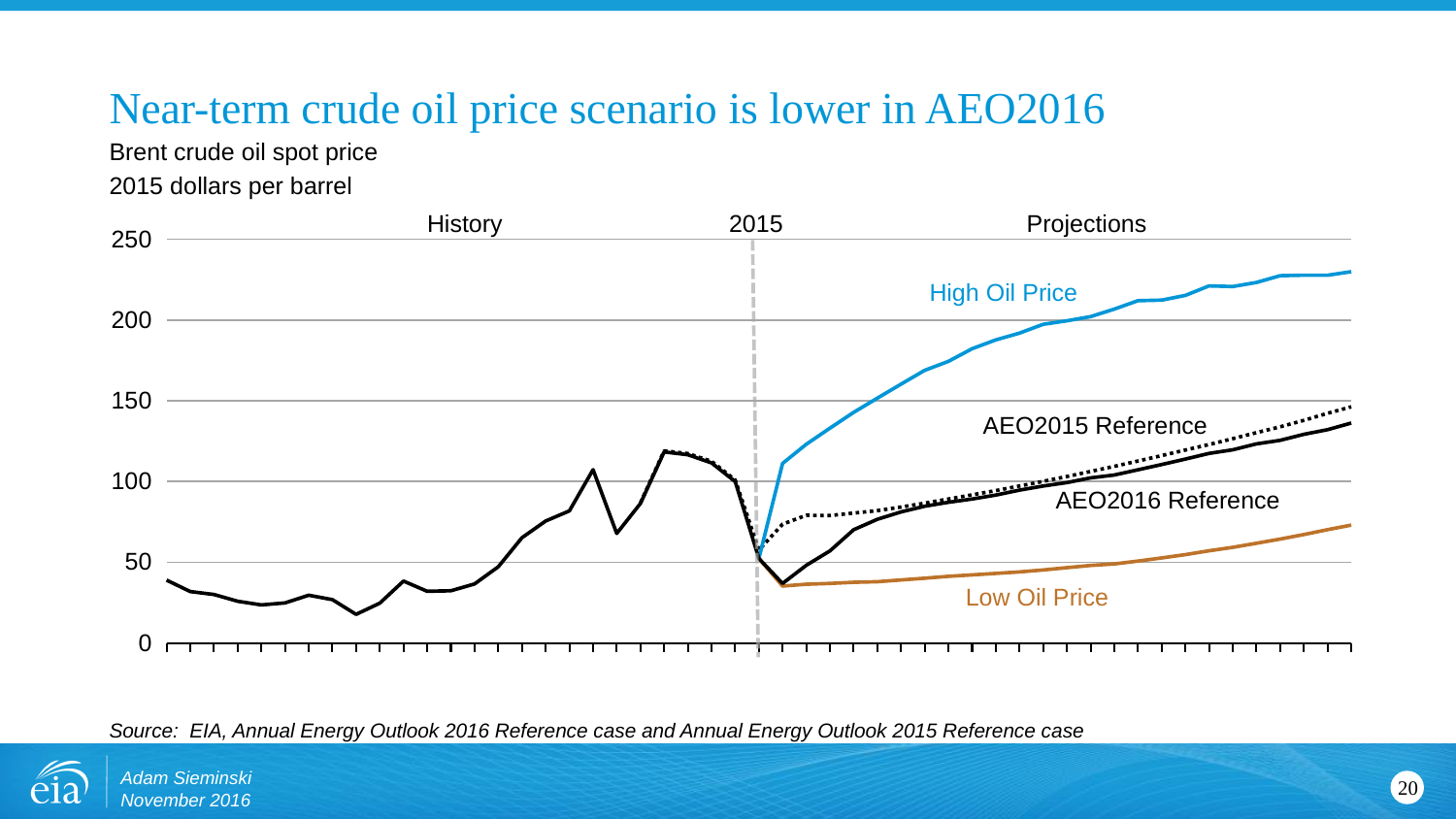
At the end of the projection period, which is higher: the AEO2015 Reference or the AEO2016 Reference? AEO2015 Reference Does the High Oil Price series rise or fall over the projection period? rise Is the AEO2016 Reference value at the end of the projection period greater or less than 150? less Which projection series reaches the highest value at the end of the projection period? High Oil Price What kind of chart is shown on the slide? line chart Is the Low Oil Price value at the end of the projection period greater or less than 100? less In what units are the crude oil prices plotted? 2015 dollars per barrel Is the High Oil Price value at the end of the projection period greater or less than 200? greater What is the title of the slide's chart? Near-term crude oil price scenario is lower in AEO2016 Which projection series has the lowest value at the end of the projection period? Low Oil Price